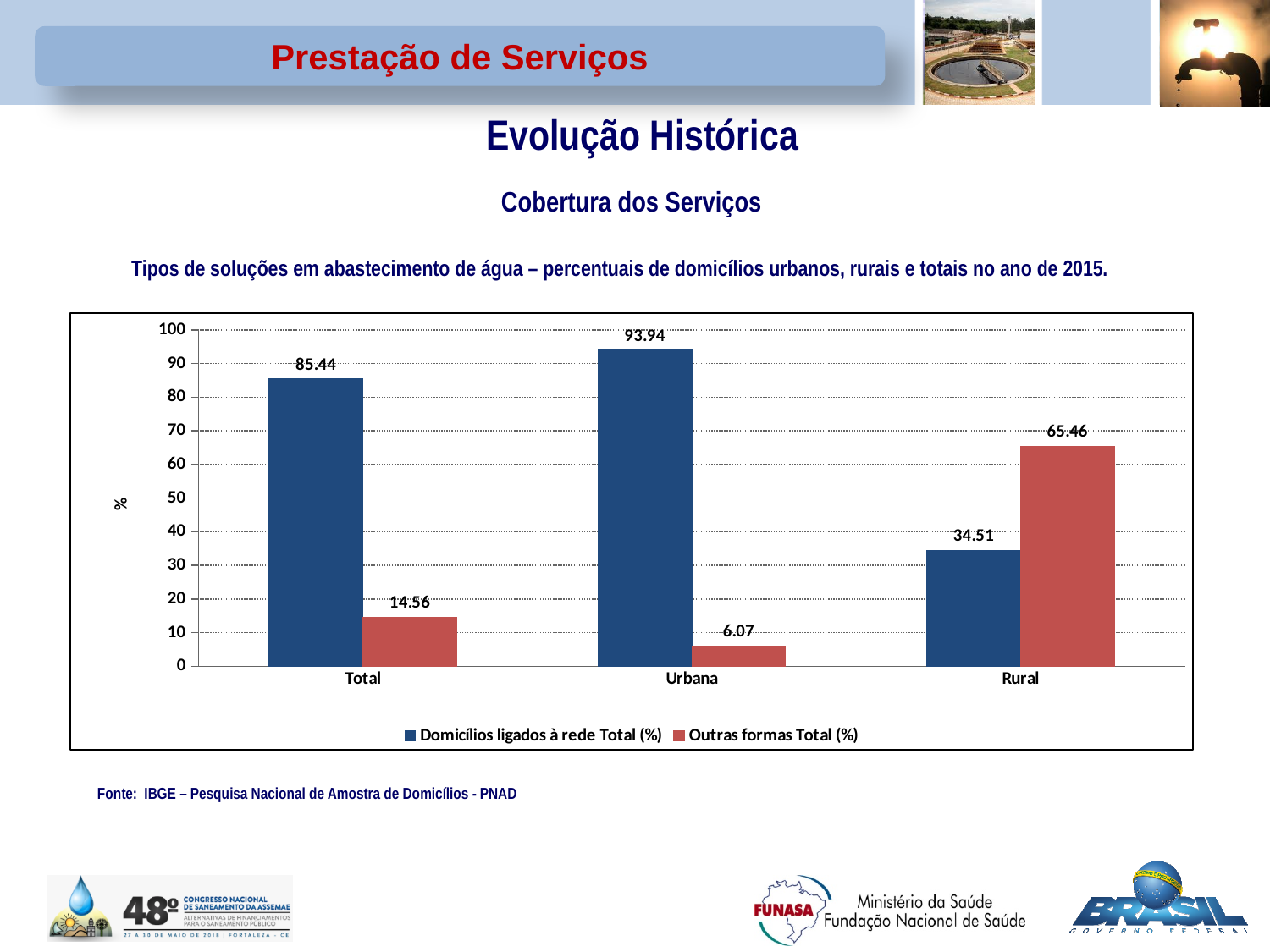
What is the label of the y axis? % What kind of chart is shown on the slide? bar chart Is the value of 'Domicílios ligados à rede Total (%)' for Rural greater or less than 40? less Which category has the lowest value for 'Outras formas Total (%)'? Urbana How many categories are shown on the x axis? 3 Which is larger for Total: 'Domicílios ligados à rede Total (%)' or 'Outras formas Total (%)'? Domicílios ligados à rede Total (%) How many series does the legend list? 2 Which category has the highest value for 'Domicílios ligados à rede Total (%)'? Urbana What is the value of 'Outras formas Total (%)' for Rural? 65.46 What is the value of 'Outras formas Total (%)' for Total? 14.56 What is the difference between 'Domicílios ligados à rede Total (%)' and 'Outras formas Total (%)' for Rural? 30.95 What is the value of 'Domicílios ligados à rede Total (%)' for Urbana? 93.94